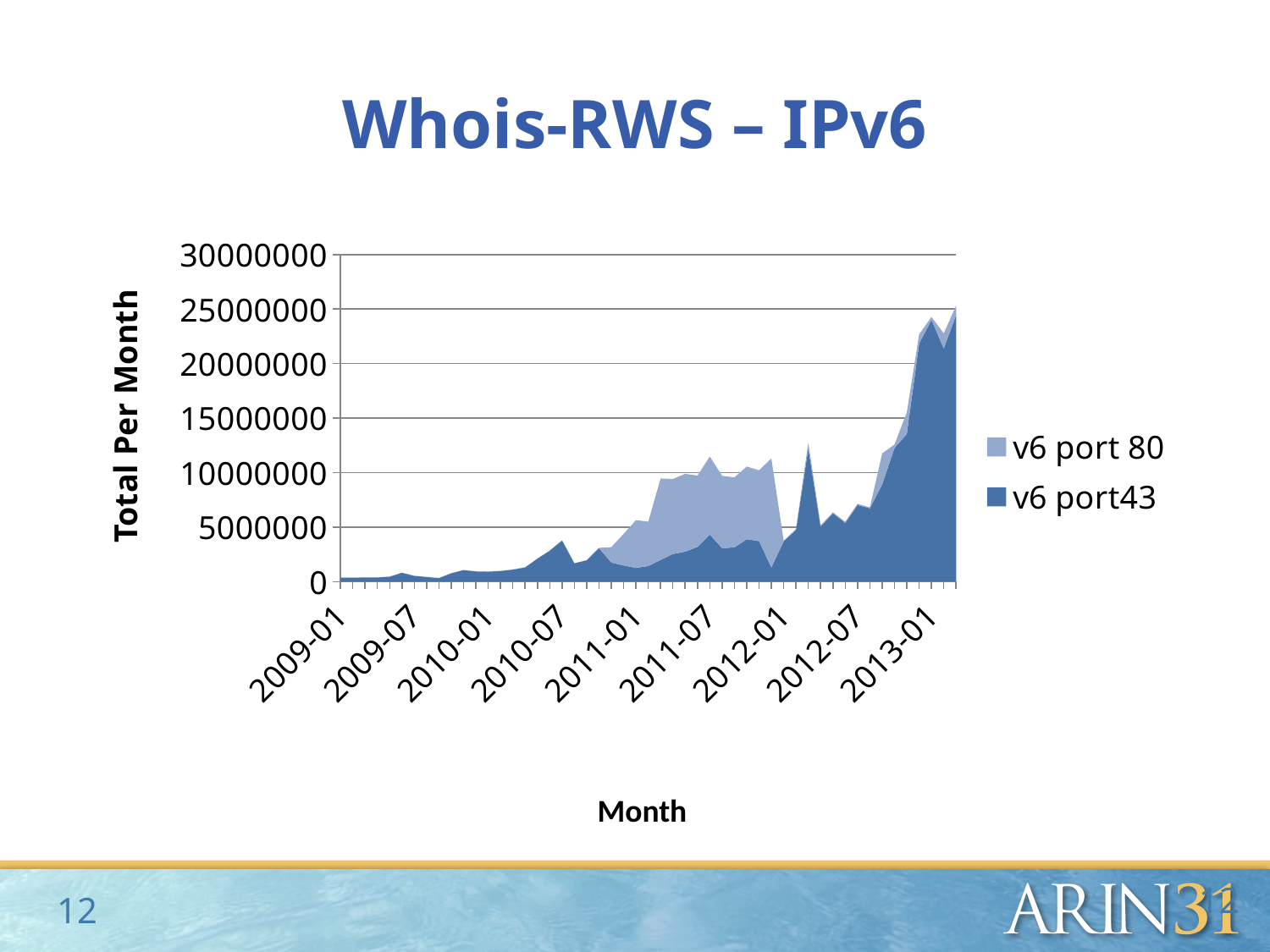
How many labelled tick marks are shown on the x axis? 9 Do the plotted totals generally rise or fall from 2009-01 to 2013-01? rise What are the two series named in the legend? v6 port 80 and v6 port43 Is the highest point reached by the chart near 2013-01 greater or less than 20000000? greater Is the value for v6 port43 at 2009-01 greater or less than 5000000? less Is the top of the plotted area at 2011-07 greater or less than 5000000? greater What is the title of the vertical axis? Total Per Month What is the highest value labelled on the vertical axis? 30000000 Which period has the higher plotted total, 2010-01 or 2013-01? 2013-01 What kind of chart is shown on the slide? area chart How many series does the legend list? 2